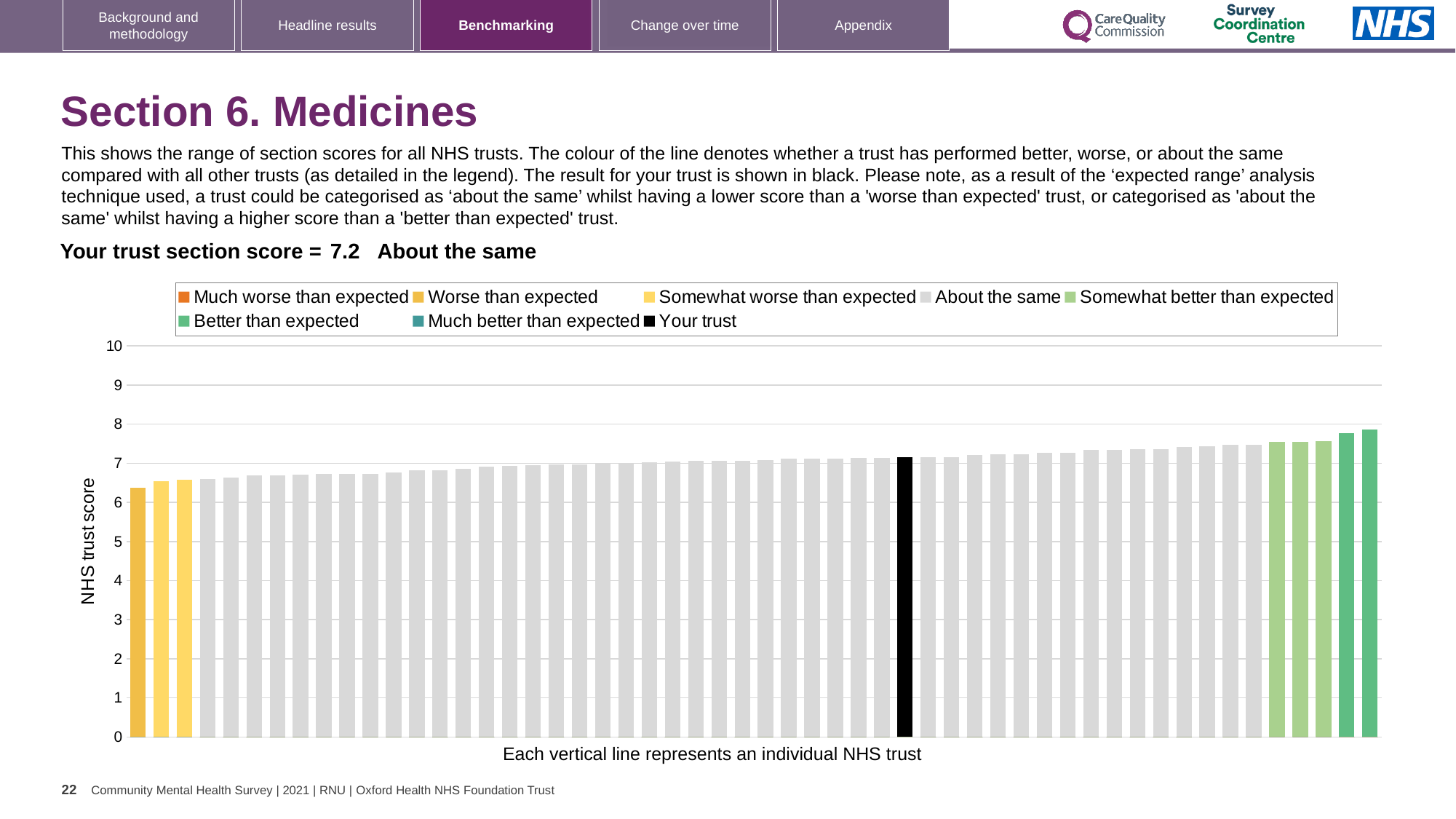
How many entries does the chart legend list? 8 What is the label on the vertical axis of the chart? NHS trust score Is the value of the tallest bar greater or less than 8? less How many bars are coloured as 'Worse than expected' (yellow)? 1 Is the value of the shortest bar greater or less than 6? greater What kind of chart is shown on the slide? bar chart What is the section score for your trust shown on the slide? 7.2 Do the bar values rise or fall from left to right along the x axis? rise Is the value of the black bar (your trust) greater or less than 5? greater Which performance category is your trust placed in according to the slide? About the same